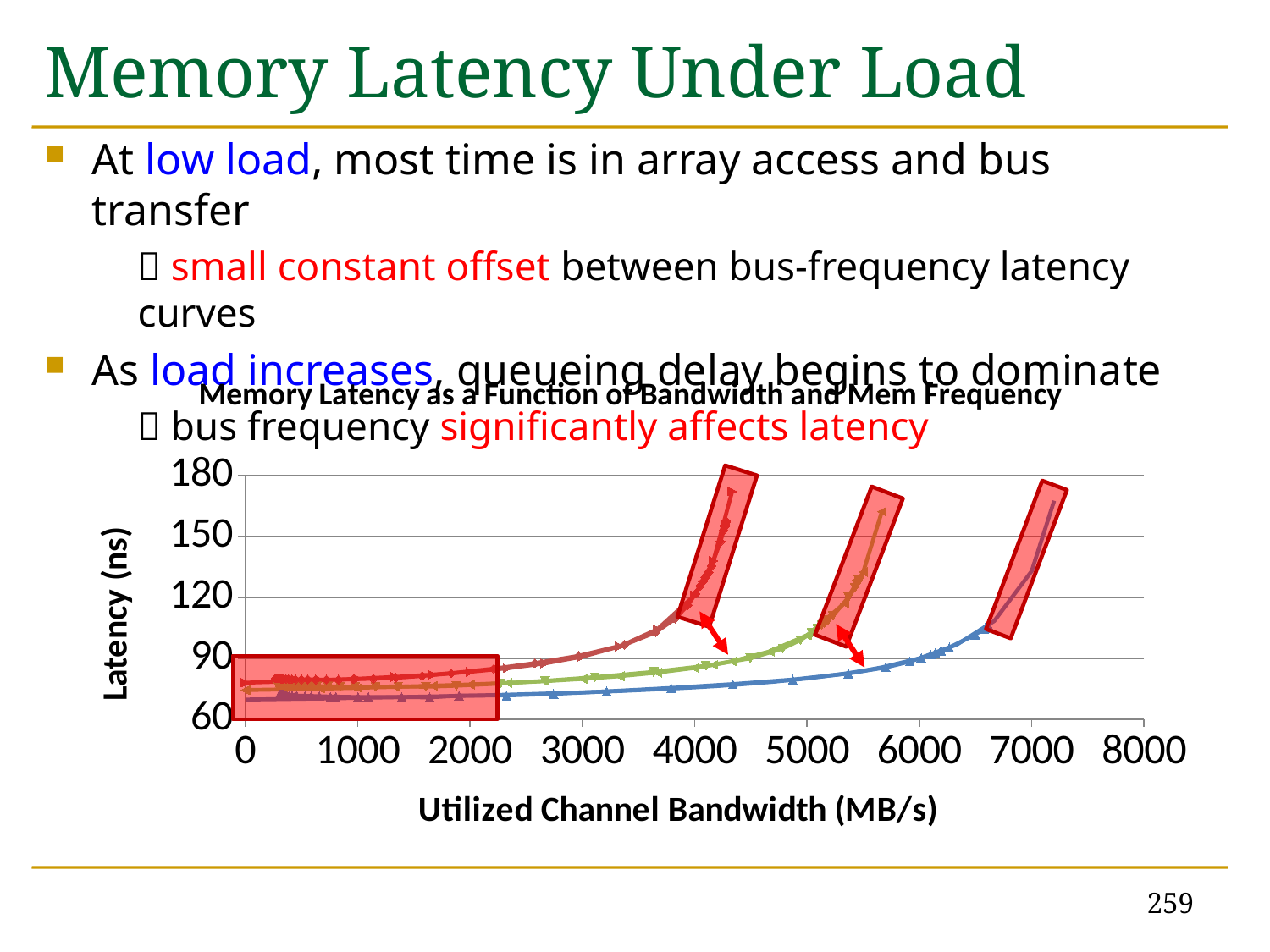
Is the latency of the green curve at 5000 MB/s greater or less than 90 ns? greater Which curve begins its steep latency rise at the lowest bandwidth: the red, green or blue one? red Is the latency of the blue curve at 2000 MB/s greater or less than 90 ns? less What kind of chart is shown on the slide? line chart What is the highest value shown on the y axis of the chart? 180 Is the latency of the red curve at 4000 MB/s greater or less than 90 ns? greater What is the label of the x axis of the chart? Utilized Channel Bandwidth (MB/s) Which curve has the lowest latency at low bandwidth (near 0 MB/s): the red, green or blue one? blue As utilized channel bandwidth increases along the x axis, does latency rise or fall? rise What is the title of the chart? Memory Latency as a Function of Bandwidth and Mem Frequency